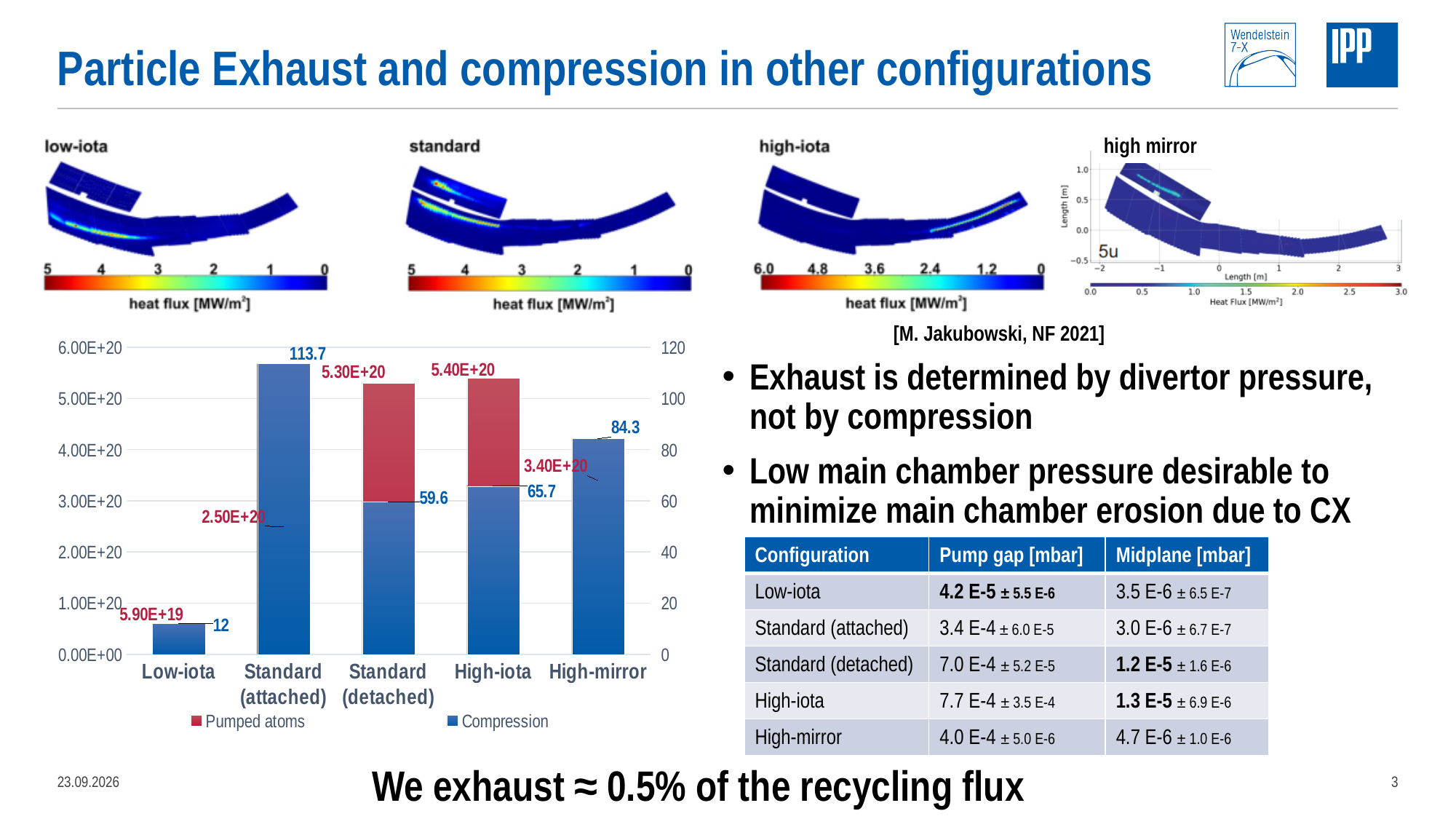
How many series does the legend of the bar chart list? 2 Which has a larger Compression value, High-iota or High-mirror? High-mirror Which configuration has the lowest Pumped atoms value? Low-iota Which colour represents the Pumped atoms series in the bar chart? red Which configuration has the highest Compression value? Standard (attached) What is the Pumped atoms value for Low-iota? 5.90E+19 What is the difference in Compression between Standard (attached) and Standard (detached)? 54.1 What is the Pumped atoms value for High-iota? 5.40E+20 What is the Compression value for Standard (attached)? 113.7 How many configurations are shown on the x axis of the bar chart? 5 What is the Compression value for High-mirror? 84.3 What kind of chart is used to show Pumped atoms and Compression? bar chart